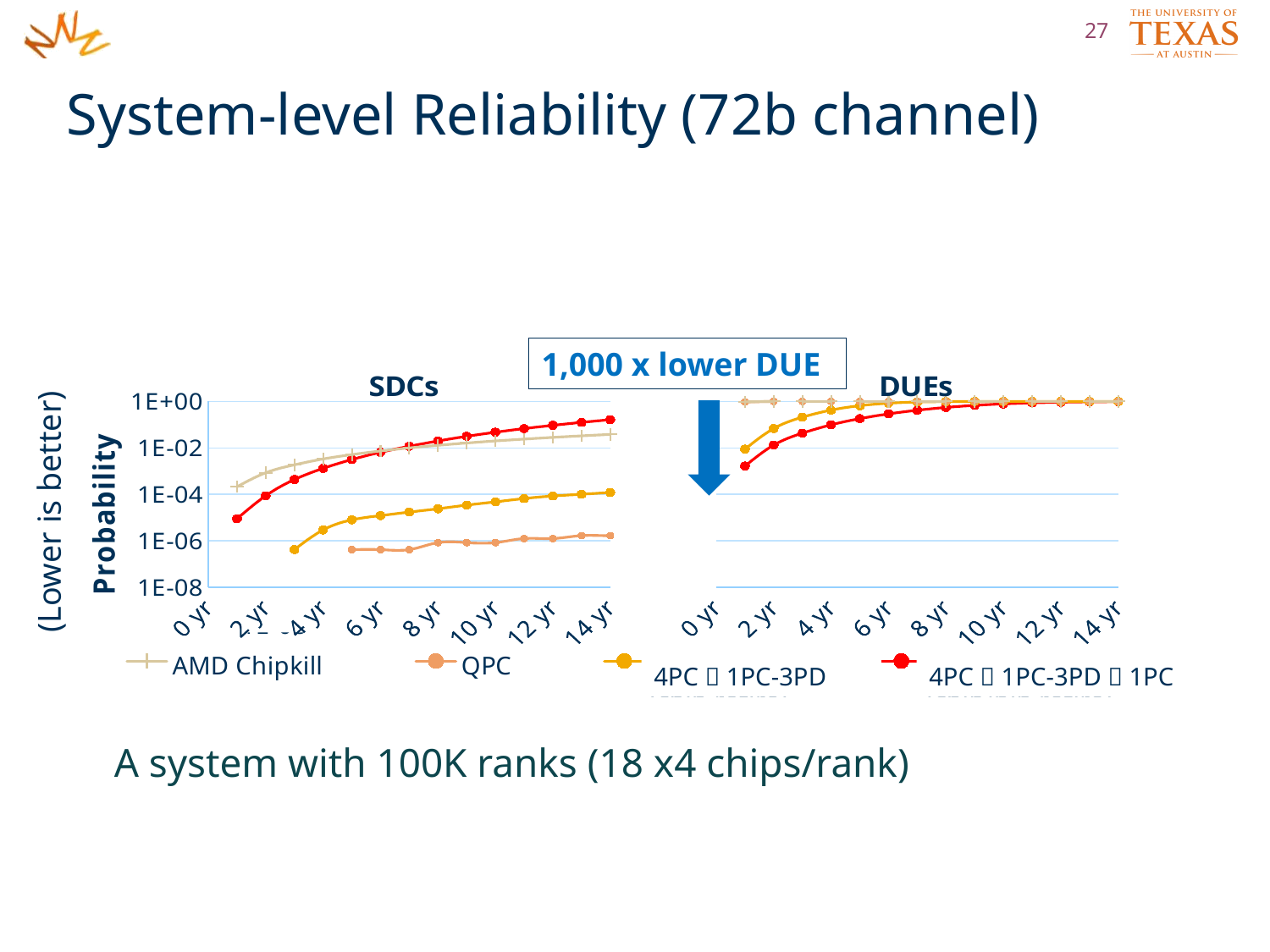
What does the annotation box above the DUEs chart say? 1,000 x lower DUE How many year labels are shown on the x axis of the DUEs chart? 8 What kind of chart is the SDCs chart? line chart In the SDCs chart, which is larger at 14 yr: AMD Chipkill or QPC? AMD Chipkill In the SDCs chart, is the value for 4PC → 1PC-3PD → 1PC at 14 yr greater or less than 1E-02? greater In the SDCs chart, which series has the lowest probability at 14 yr? QPC In the DUEs chart, is the value for AMD Chipkill at 14 yr greater or less than 1E-02? greater In the SDCs chart, is the value for QPC at 14 yr greater or less than 1E-04? less How many series does the legend list? 4 In the SDCs chart, do the probabilities rise or fall as the years increase? rise In the SDCs chart, which series has the highest probability at 14 yr? 4PC → 1PC-3PD → 1PC